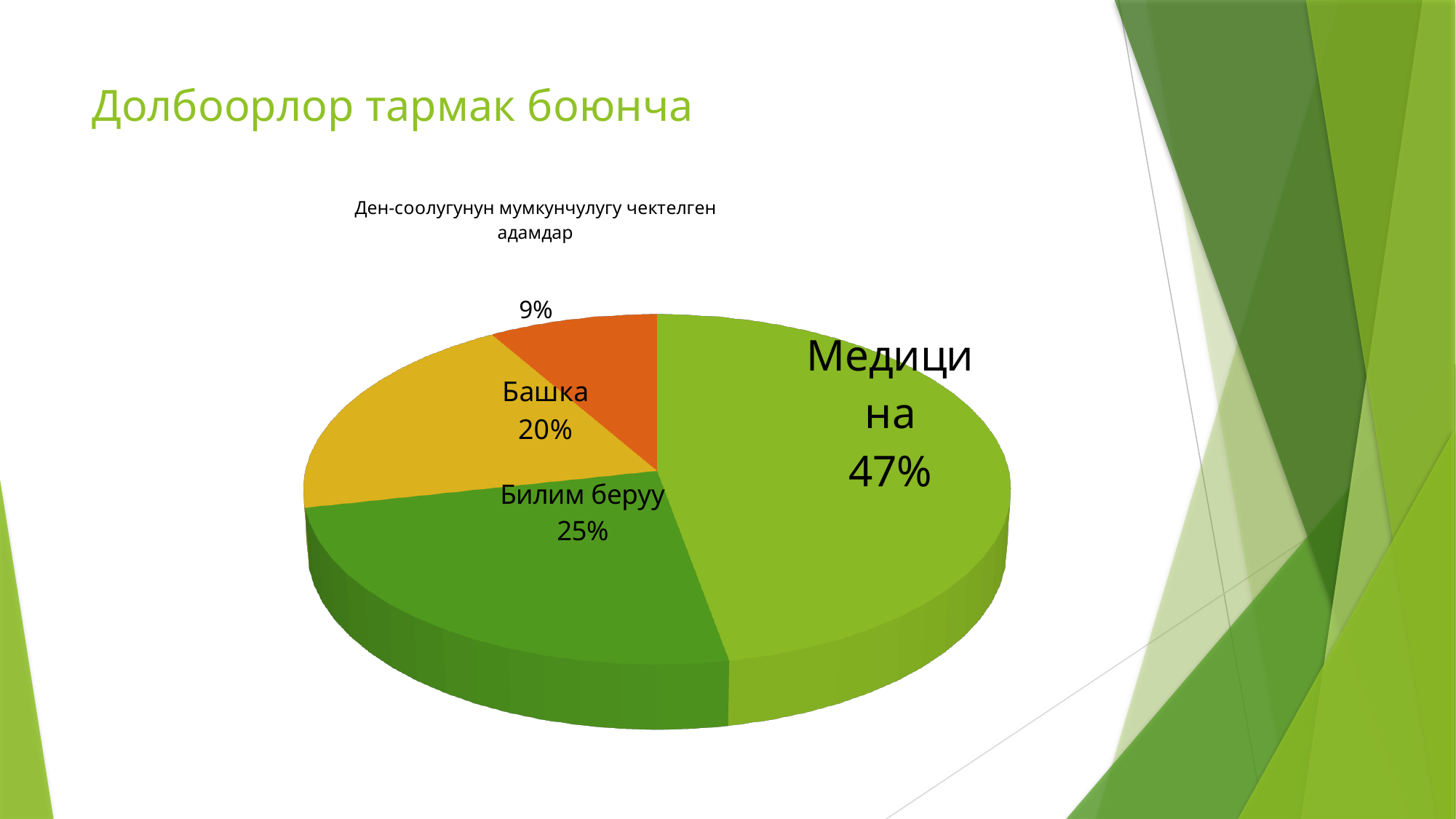
What kind of chart is shown on the slide? pie chart How many slices does the pie chart have? 4 What share of the pie does Медицина have? 47% What is the difference in percentage points between Медицина and Билим беруу? 22 What is the percentage of the smallest slice of the pie? 9% Which is larger, the share for Башка or the share for Билим беруу? Билим беруу What is the title of the slide? Долбоорлор тармак боюнча What percentage is shown for Башка? 20% Which slice of the pie is the largest? Медицина What colour is the slice labelled Башка? yellow What percentage is shown for Билим беруу? 25% What is the difference in percentage points between Билим беруу and Башка? 5